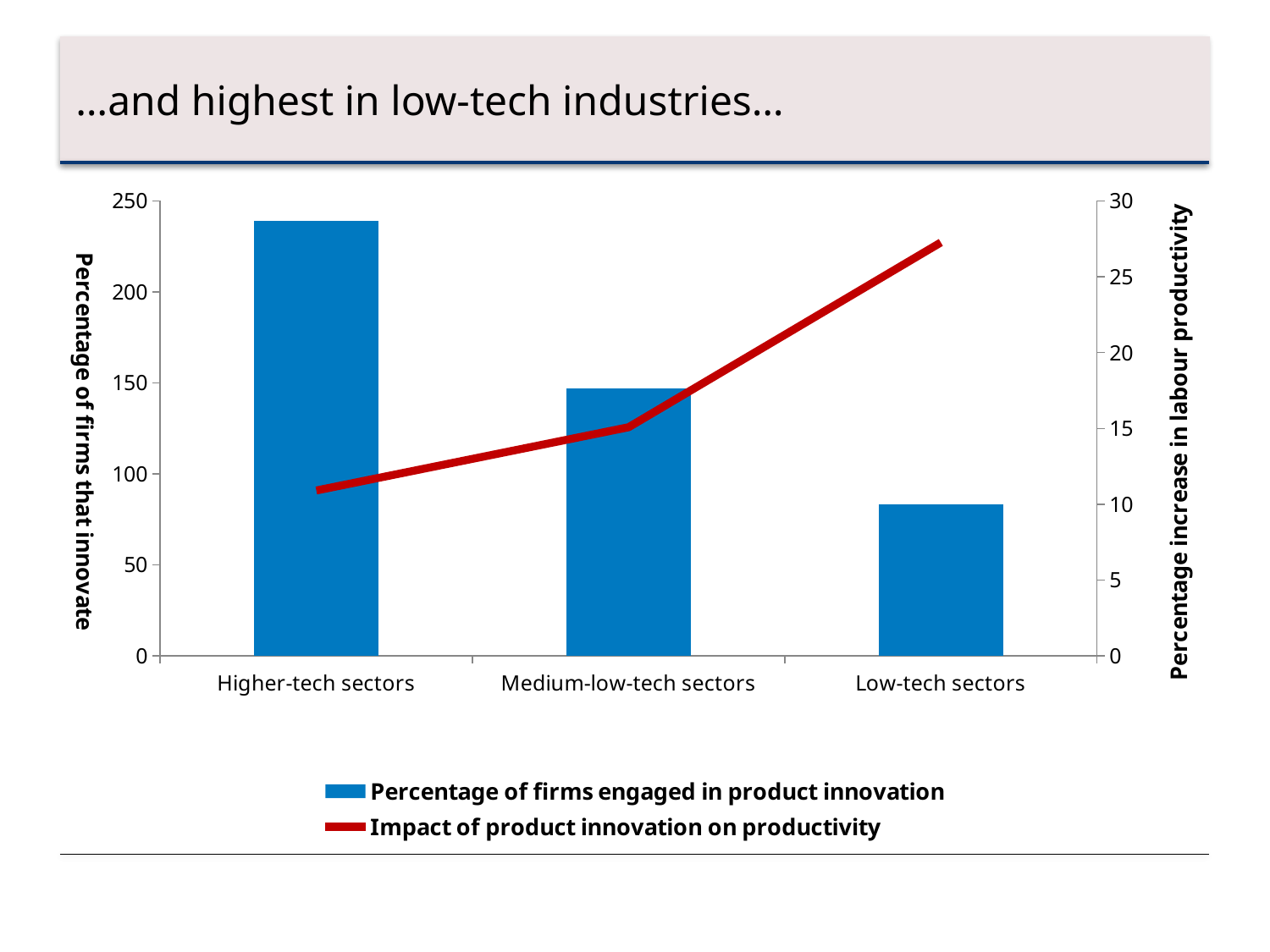
Which sector has the highest value for Percentage of firms engaged in product innovation? Higher-tech sectors How many series does the legend list? 2 How many sector categories are shown on the x axis? 3 Does the Impact of product innovation on productivity line rise or fall from Higher-tech sectors to Low-tech sectors? rise Which sector has the lowest value for Percentage of firms engaged in product innovation? Low-tech sectors Is the Percentage of firms engaged in product innovation bar for Low-tech sectors greater or less than 100? less Is the Percentage of firms engaged in product innovation bar for Higher-tech sectors greater or less than 200? greater Do the bars for Percentage of firms engaged in product innovation rise or fall from Higher-tech sectors to Low-tech sectors? fall Which sector has the highest value for Impact of product innovation on productivity? Low-tech sectors Which is larger for Percentage of firms engaged in product innovation: Medium-low-tech sectors or Low-tech sectors? Medium-low-tech sectors Which sector has the lowest value for Impact of product innovation on productivity? Higher-tech sectors Is the Impact of product innovation on productivity value for Low-tech sectors greater or less than 25? greater